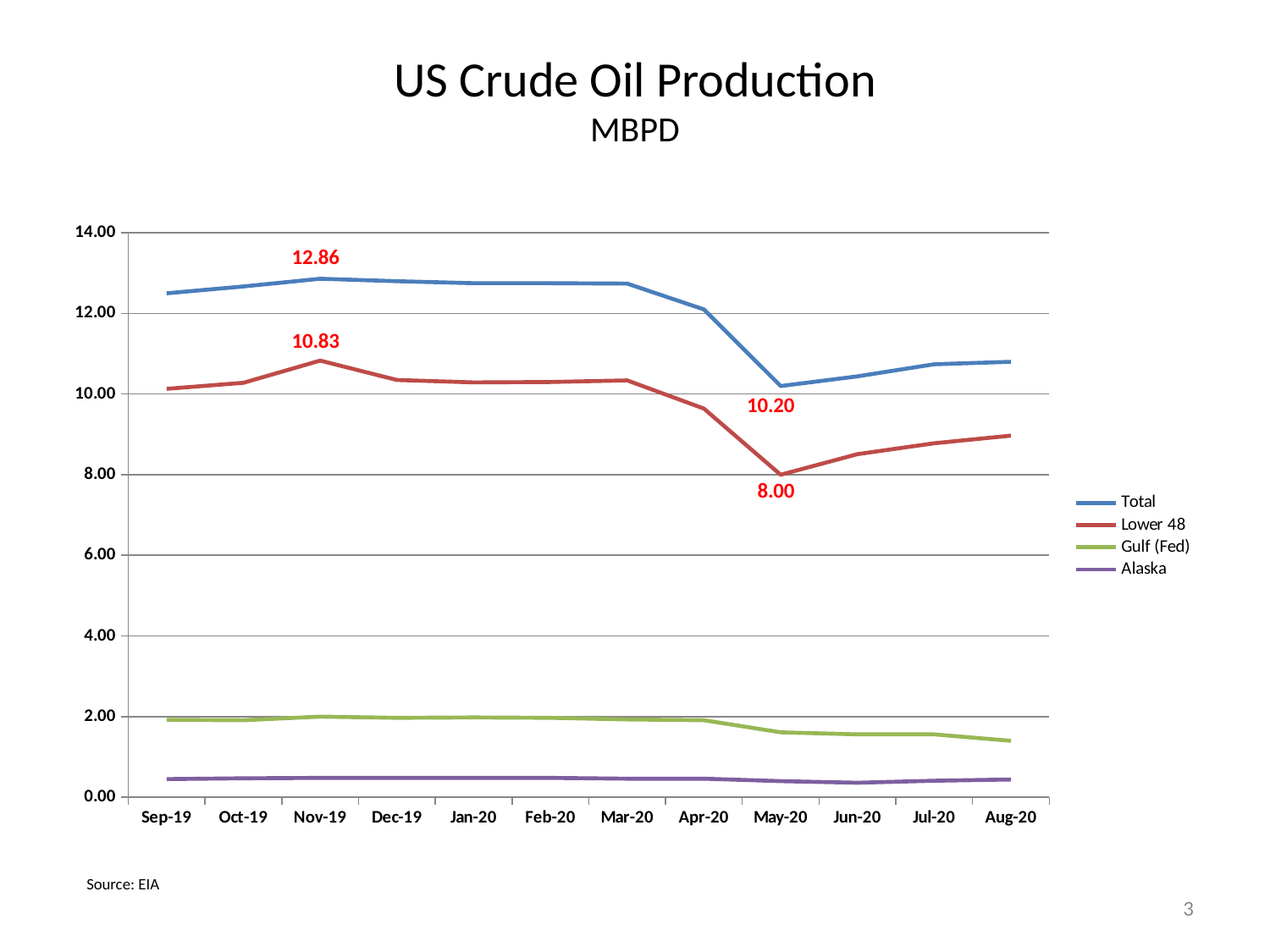
What is the value of the Lower 48 series in May-20? 8.00 What is the difference between the Lower 48 values in Nov-19 and May-20? 2.83 By how much did the Total series fall from Nov-19 to May-20? 2.66 What is the value of the Total series in Nov-19? 12.86 How many series does the legend list? 4 What is the value of the Total series in May-20? 10.20 Is the value for Gulf (Fed) in Aug-20 greater or less than 2.00? less What kind of chart is shown on the slide? Line chart What is the value of the Lower 48 series in Nov-19? 10.83 In Nov-19, how much higher is the Total value than the Lower 48 value? 2.03 How many months are plotted along the x axis? 12 Which is larger, the Total value in Nov-19 or the Total value in May-20? Nov-19